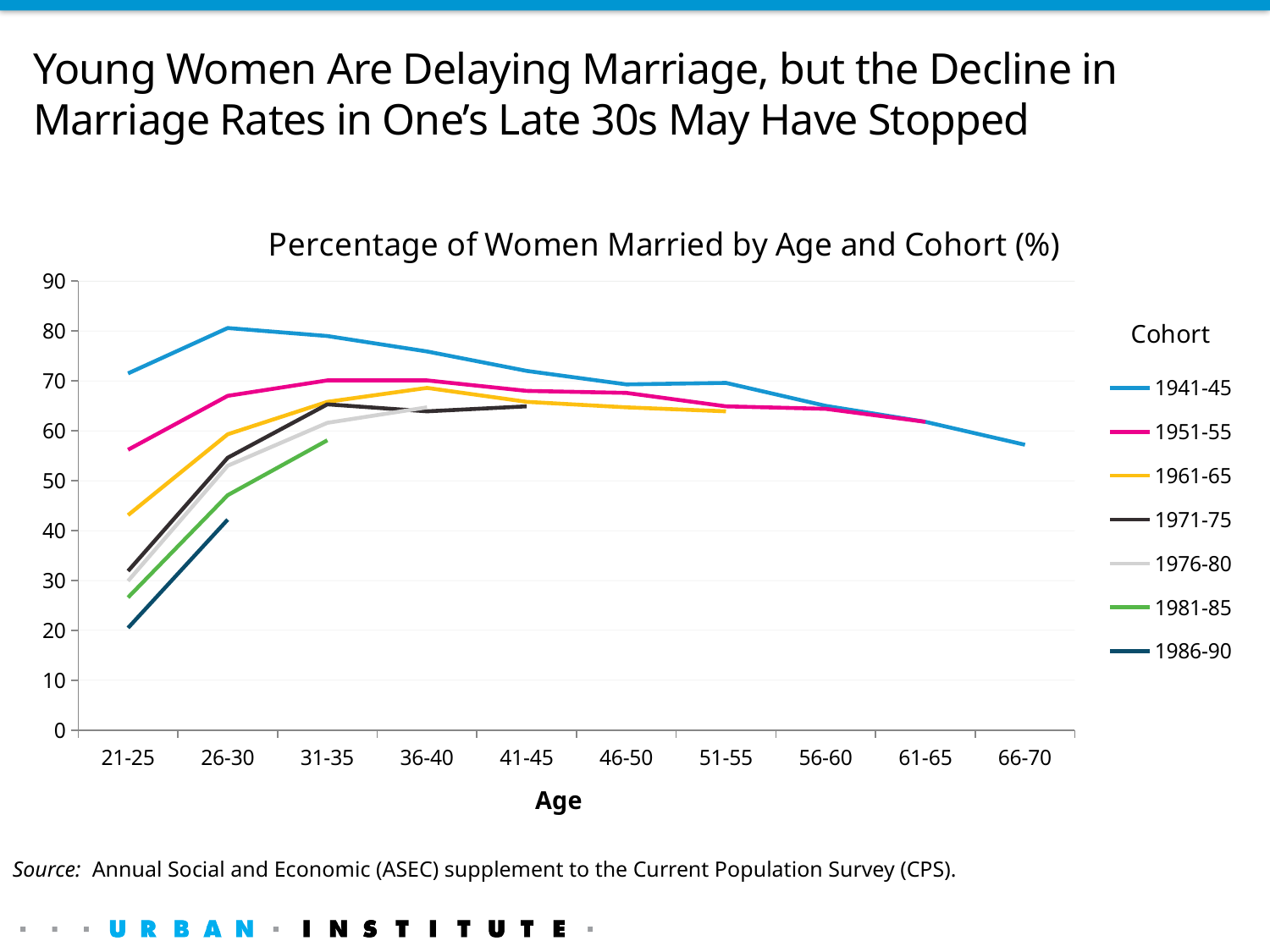
Which cohort has the highest percentage married at age 21-25? 1941-45 Is the value for the 1961-65 cohort at age 21-25 greater or less than 40? greater Is the value for the 1986-90 cohort at age 21-25 greater or less than 30? less Is the value for the 1941-45 cohort at age 66-70 greater or less than 60? less Does the 1941-45 cohort's line rise or fall from age 26-30 to age 66-70? fall How many cohorts does the legend list? 7 What is the title of the chart? Percentage of Women Married by Age and Cohort (%) What kind of chart is shown on the slide? line chart Which cohort has the lowest percentage married at age 21-25? 1986-90 How many age groups are shown along the x axis? 10 At age 26-30, which cohort has the higher percentage married: 1951-55 or 1961-65? 1951-55